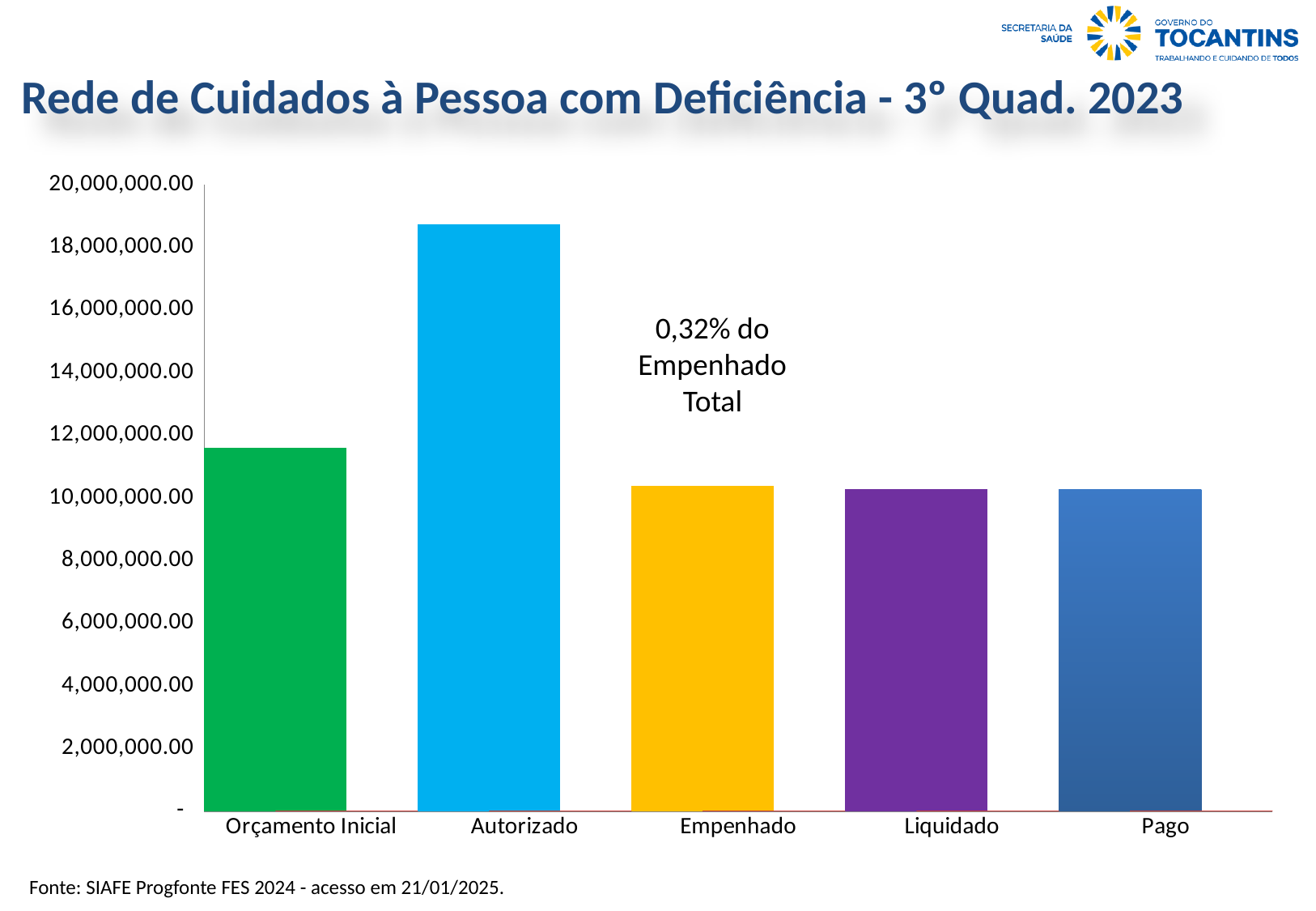
What is the title of the chart? Rede de Cuidados à Pessoa com Deficiência - 3° Quad. 2023 How many categories are plotted on the x axis? 5 Is the value for Pago greater or less than 12,000,000.00? less What kind of chart is shown on the slide? bar chart Is the value for Orçamento Inicial greater or less than 10,000,000.00? greater Is the value for Orçamento Inicial greater or less than 12,000,000.00? less What percentage of the Empenhado Total does the annotation on the chart state? 0,32% Which is larger, the value for Orçamento Inicial or the value for Empenhado? Orçamento Inicial Which category has the highest value? Autorizado Which is larger, the value for Orçamento Inicial or the value for Autorizado? Autorizado